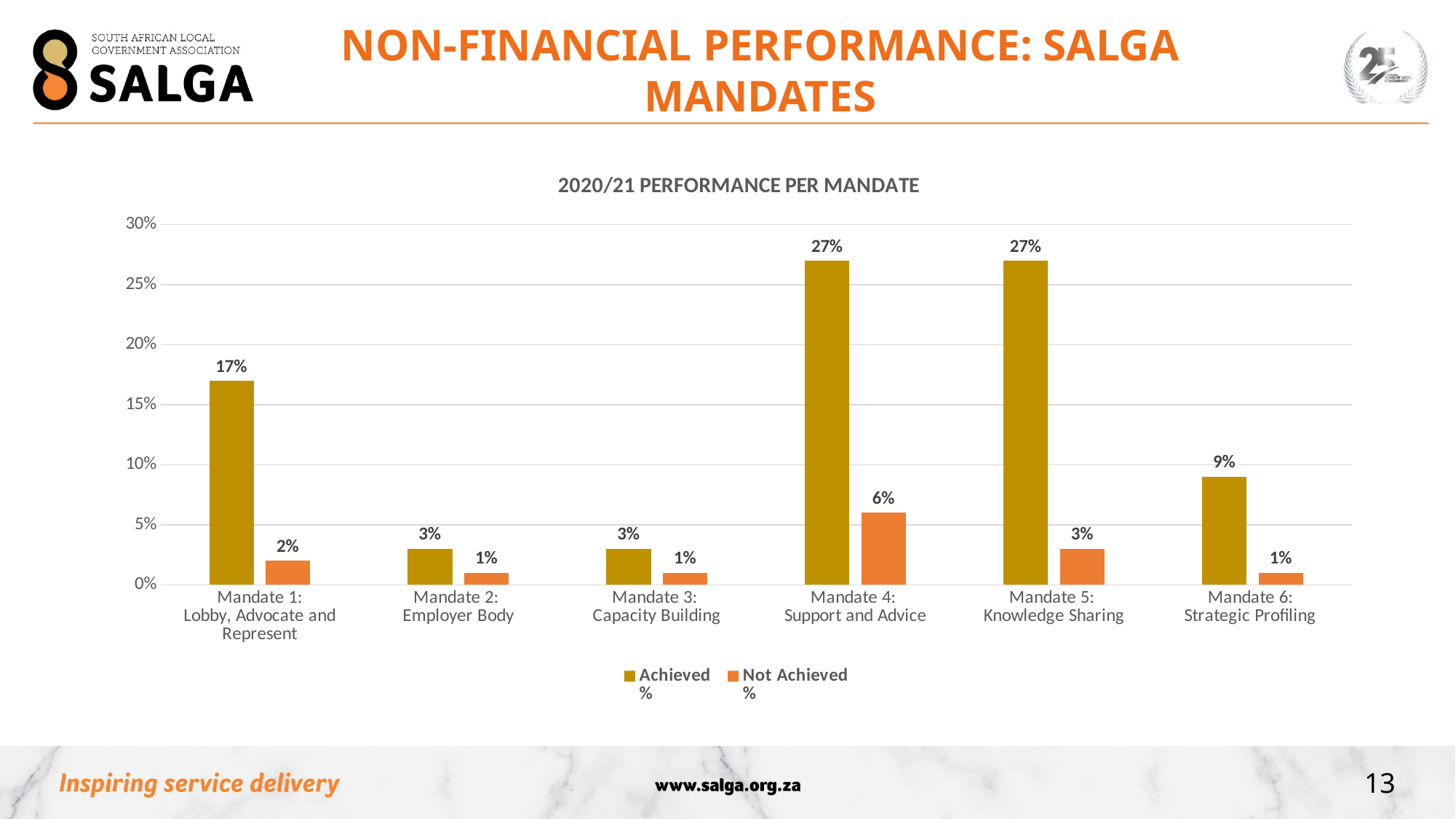
What is the difference between the Achieved % and Not Achieved % values for Mandate 4: Support and Advice? 21% What is the title of the chart? 2020/21 PERFORMANCE PER MANDATE Which is larger: the Achieved % for Mandate 1: Lobby, Advocate and Represent or the Achieved % for Mandate 6: Strategic Profiling? Mandate 1: Lobby, Advocate and Represent How many series does the chart legend list? 2 What kind of chart is shown on the slide? Bar chart Which mandate has the highest Not Achieved % value? Mandate 4: Support and Advice Is the Achieved % value for Mandate 5: Knowledge Sharing greater or less than 25%? greater Which mandate has the lowest Achieved % value? Mandate 2: Employer Body and Mandate 3: Capacity Building (both 3%) How many mandates are shown on the x axis of the chart? 6 What is the Not Achieved % value for Mandate 1: Lobby, Advocate and Represent? 2% What is the Achieved % value for Mandate 6: Strategic Profiling? 9% What is the Achieved % value for Mandate 4: Support and Advice? 27%